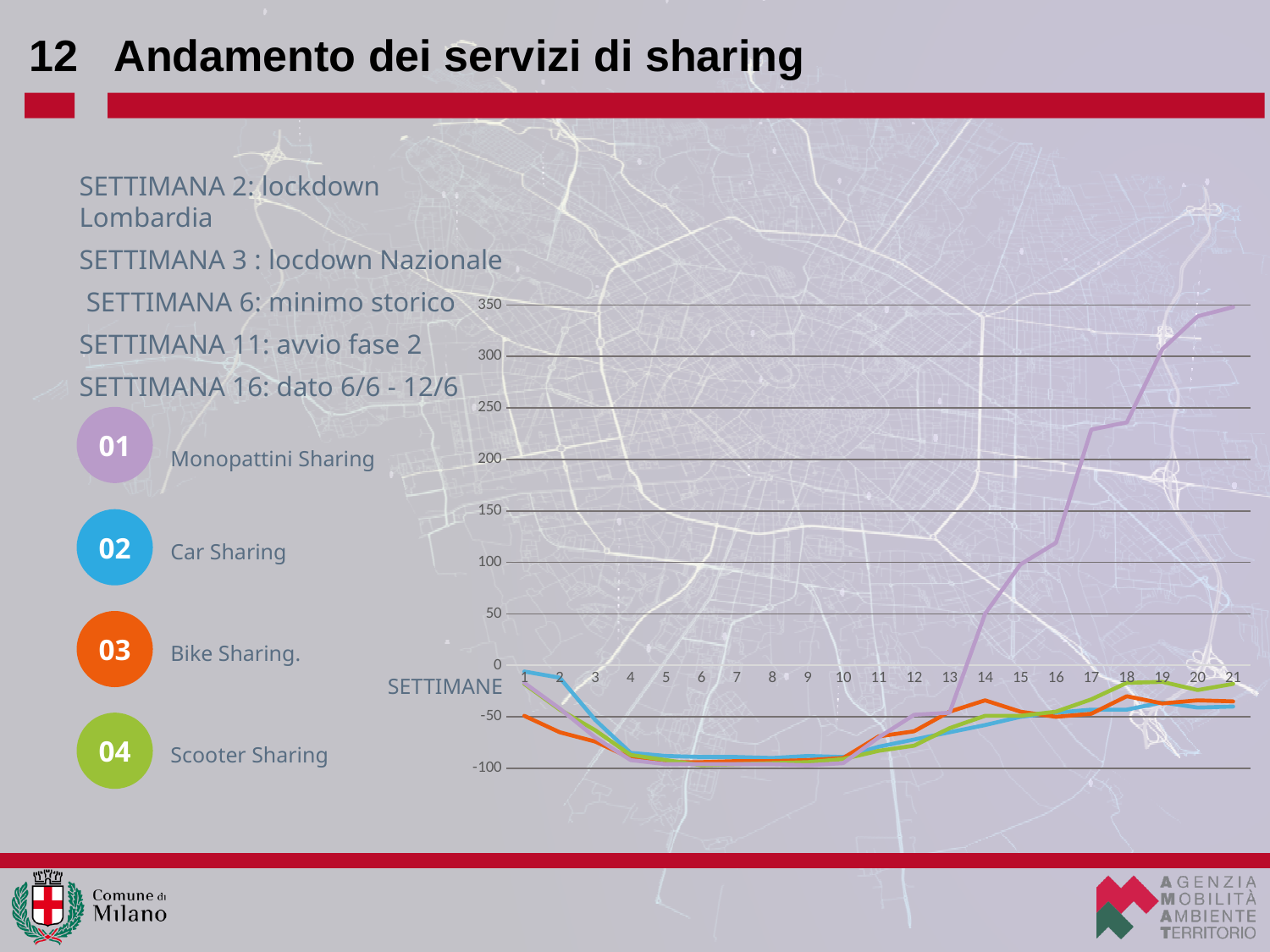
Is the value for Monopattini Sharing at week 13 greater or less than 0? less What label is shown for the x axis of the chart? SETTIMANE Is the value for Monopattini Sharing at week 21 greater or less than 300? greater Is the value for Car Sharing at week 6 greater or less than -50? less Does the Monopattini Sharing line rise or fall from week 13 to week 21? rises How many sharing services (series) are listed on the slide for the chart? 4 How many weeks (settimane) are plotted along the x axis of the chart? 21 Which series has the highest value at week 21? Monopattini Sharing What kind of chart is shown on the slide? line chart What is the title of the slide containing the chart? Andamento dei servizi di sharing Do the lines rise or fall from week 1 to week 6? fall